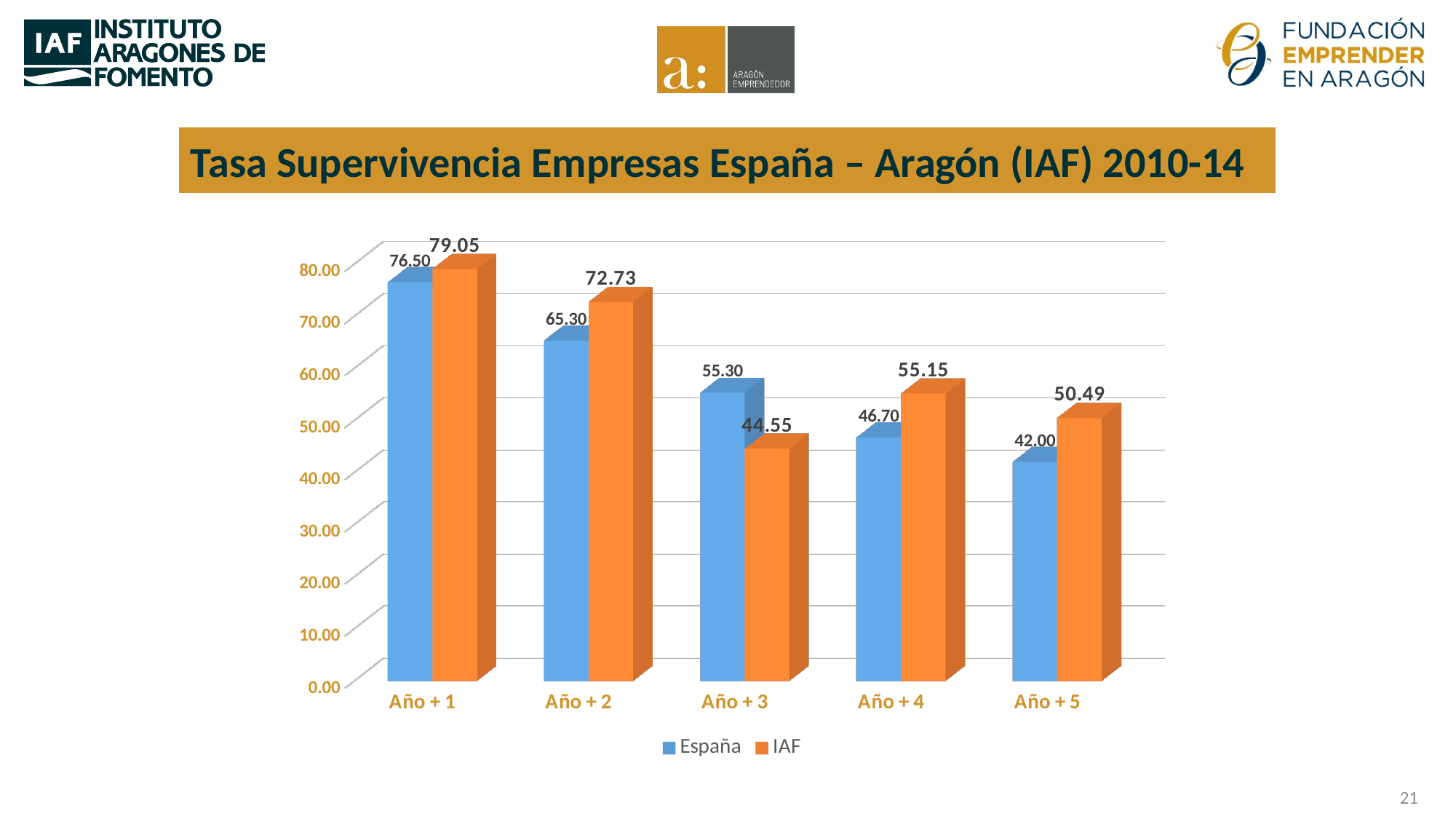
At Año + 3, which series has the larger value, España or IAF? España Which category has the highest value for the IAF series? Año + 1 What is the value for IAF at Año + 3? 44.55 How many series does the legend list? 2 What is the difference between the IAF and España values at Año + 4? 8.45 What is the value for IAF at Año + 5? 50.49 What kind of chart is shown on the slide? Bar chart Which category has the lowest value for the España series? Año + 5 What is the value for España at Año + 1? 76.50 What is the value for España at Año + 4? 46.70 Do the España values rise or fall from Año + 1 to Año + 5? Fall How many categories are shown on the x axis? 5